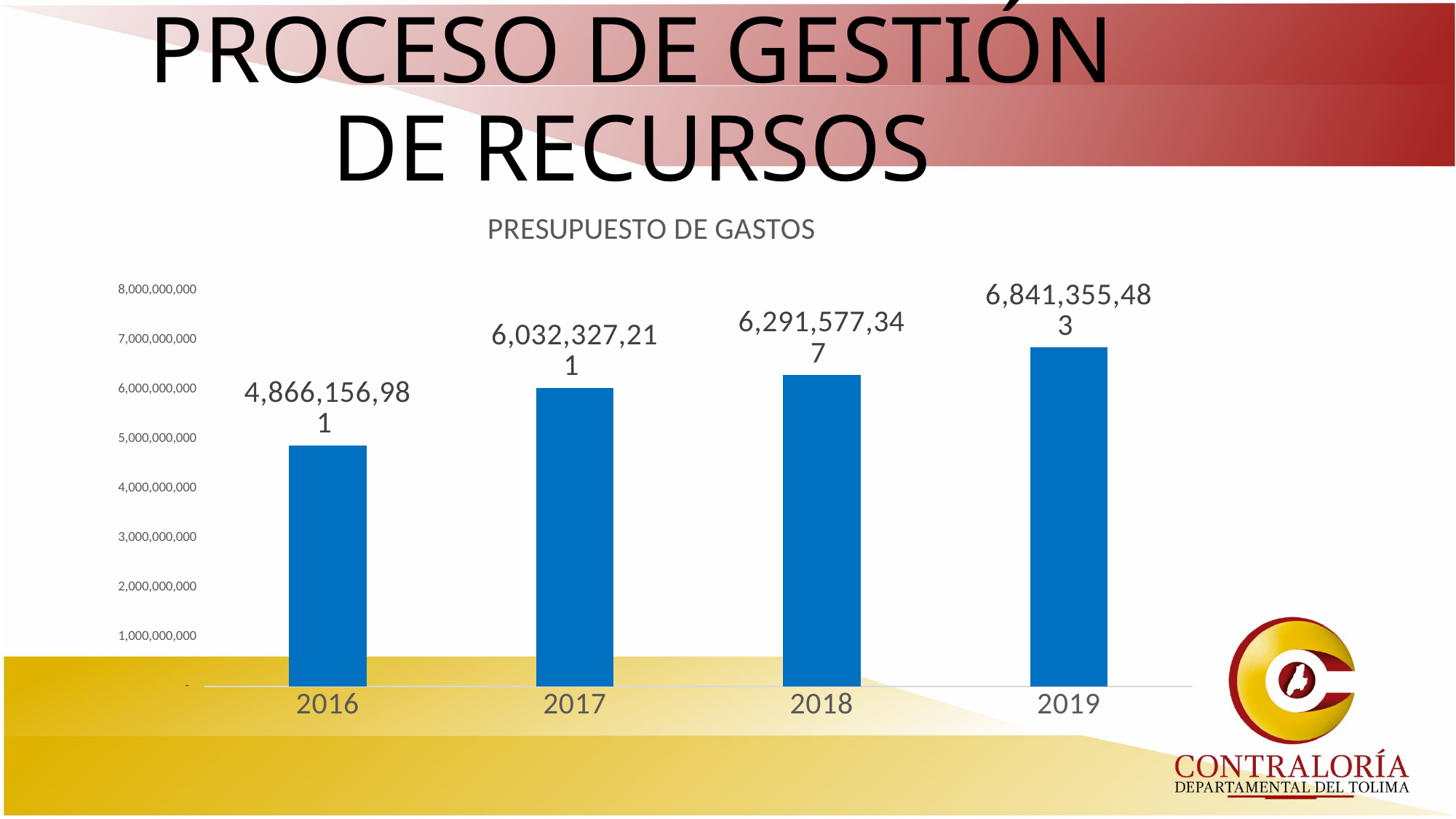
What is the difference between the 2018 and 2017 values in the PRESUPUESTO DE GASTOS chart? 259,250,136 Which is larger in the PRESUPUESTO DE GASTOS chart, the value for 2017 or the value for 2018? 2018 What is the value for 2016 in the PRESUPUESTO DE GASTOS chart? 4,866,156,981 Do the values in the PRESUPUESTO DE GASTOS chart rise or fall from 2016 to 2019? rise Which year has the highest value in the PRESUPUESTO DE GASTOS chart? 2019 What is the difference between the 2019 and 2016 values in the PRESUPUESTO DE GASTOS chart? 1,975,198,502 Which year has the lowest value in the PRESUPUESTO DE GASTOS chart? 2016 How many years are shown in the PRESUPUESTO DE GASTOS chart? 4 What is the value for 2017 in the PRESUPUESTO DE GASTOS chart? 6,032,327,211 What is the value for 2018 in the PRESUPUESTO DE GASTOS chart? 6,291,577,347 What is the value for 2019 in the PRESUPUESTO DE GASTOS chart? 6,841,355,483 Is the value for 2016 in the PRESUPUESTO DE GASTOS chart greater or less than 5,000,000,000? less